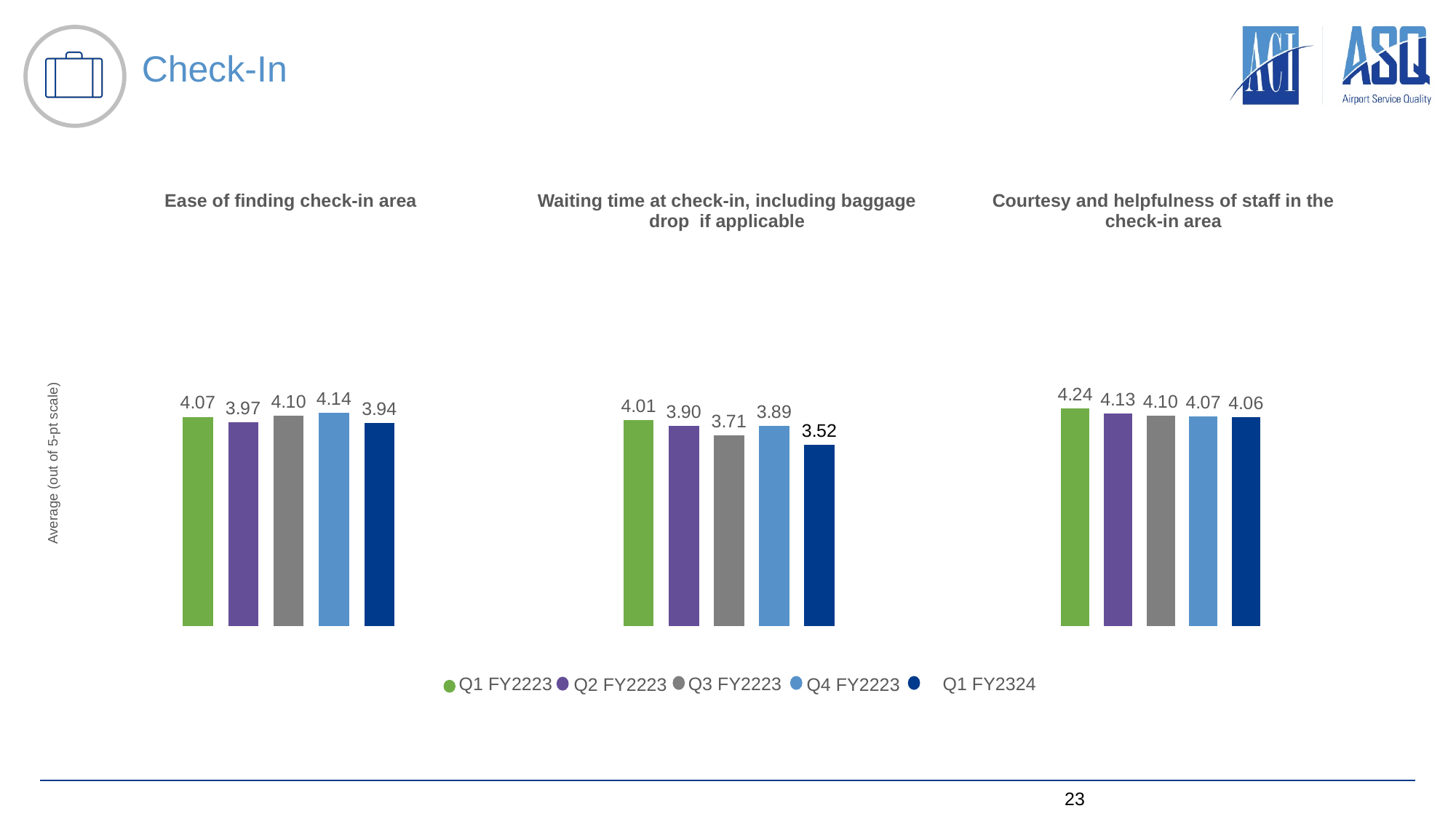
In the 'Waiting time at check-in, including baggage drop if applicable' chart, which quarter has the highest value? Q1 FY2223 In the 'Ease of finding check-in area' chart, which quarter has the lowest value? Q1 FY2324 What kind of chart is used on this slide? Bar chart In the 'Ease of finding check-in area' chart, what is the value for Q4 FY2223? 4.14 In the 'Waiting time at check-in, including baggage drop if applicable' chart, what is the value for Q1 FY2324? 3.52 In the 'Courtesy and helpfulness of staff in the check-in area' chart, what is the difference between the Q1 FY2223 value and the Q4 FY2223 value? 0.17 In the 'Courtesy and helpfulness of staff in the check-in area' chart, which quarter has the highest value? Q1 FY2223 In the 'Courtesy and helpfulness of staff in the check-in area' chart, do the values rise or fall from Q1 FY2223 to Q1 FY2324? Fall How many series does the legend list? 5 In the 'Courtesy and helpfulness of staff in the check-in area' chart, what is the value for Q2 FY2223? 4.13 In the 'Ease of finding check-in area' chart, which is larger: the value for Q3 FY2223 or the value for Q2 FY2223? Q3 FY2223 In the 'Waiting time at check-in, including baggage drop if applicable' chart, what is the difference between the Q1 FY2223 value and the Q1 FY2324 value? 0.49